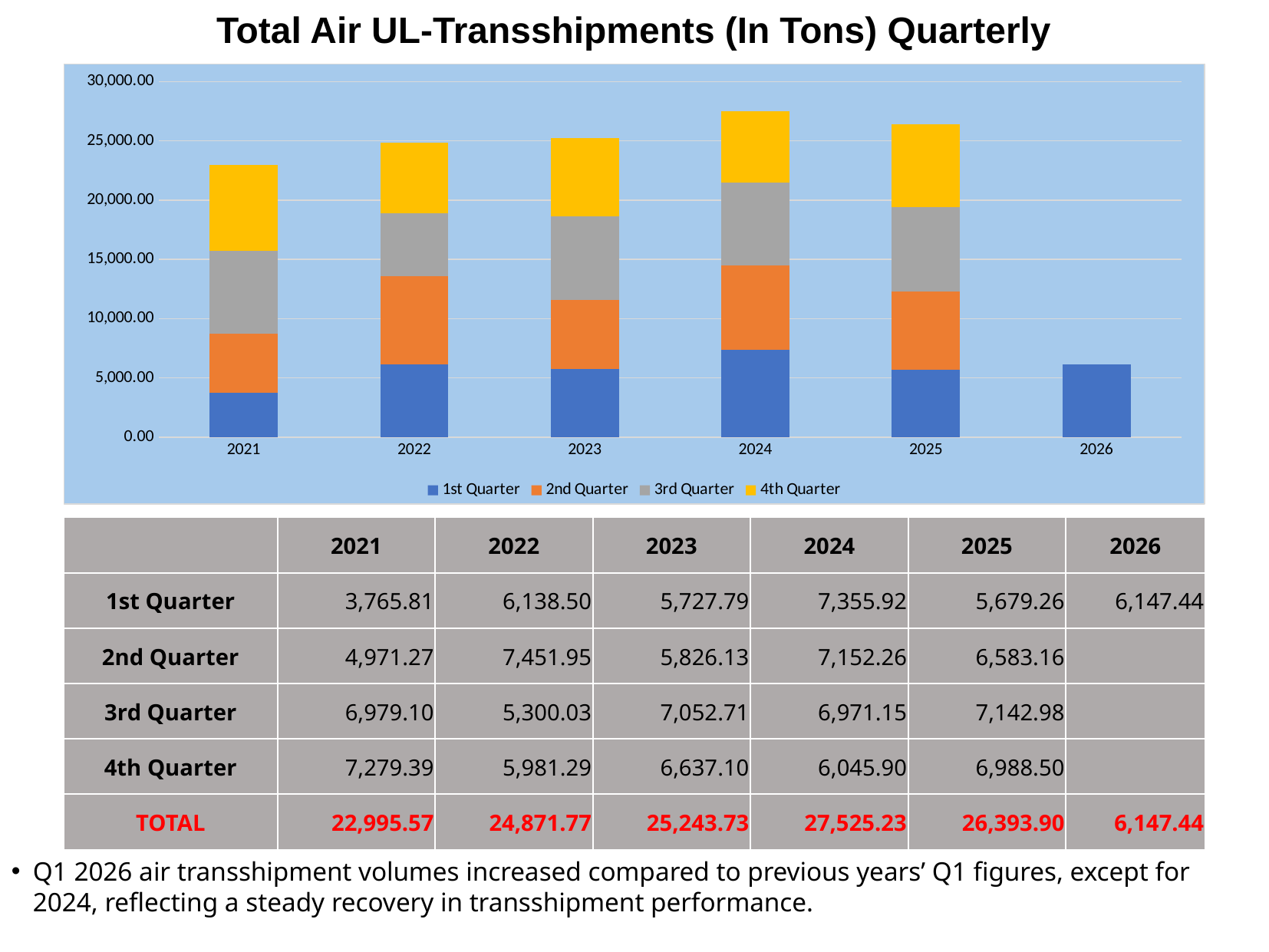
Is the total stacked bar for 2021 greater or less than 25,000.00? less What is the total of the stacked bar for 2024? 27,525.23 What is the 1st Quarter value for 2024? 7,355.92 How many series does the legend list? 4 Which year has the lowest total stacked bar? 2026 How many years are shown along the x axis? 6 What is the 4th Quarter value for 2021? 7,279.39 Which year has the larger 2nd Quarter value, 2022 or 2025? 2022 What colour represents the 4th Quarter in the chart? Yellow Which year has the highest total stacked bar? 2024 What kind of chart is shown on the slide? Stacked bar chart What is the difference between the 1st Quarter values for 2024 and 2021? 3,590.11